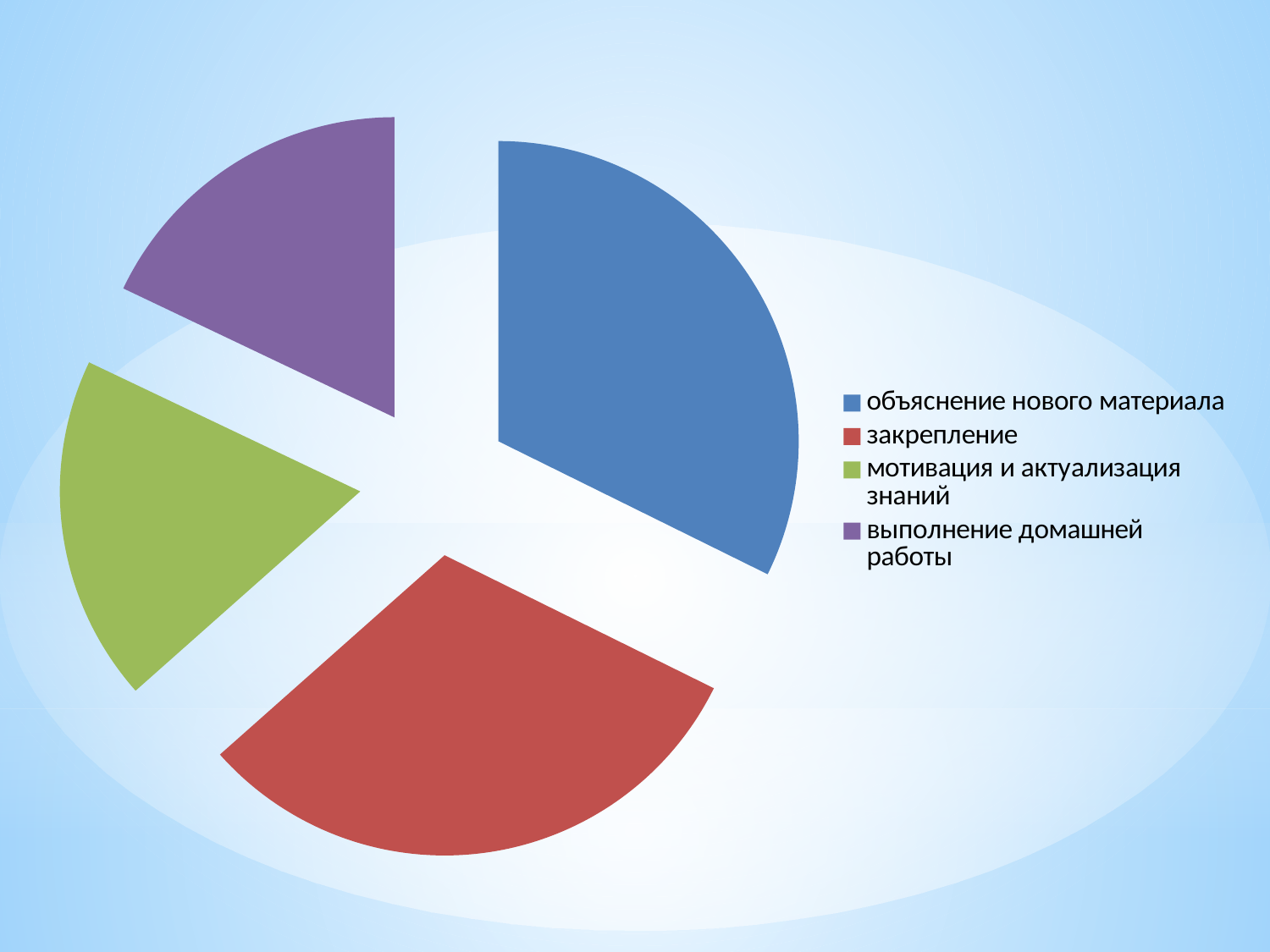
Which category is shown in purple in the pie chart? выполнение домашней работы Which slice is larger: закрепление or выполнение домашней работы? закрепление How many entries does the legend of the pie chart list? 4 Which slice is larger: закрепление or мотивация и актуализация знаний? закрепление Which slice is larger: объяснение нового материала or выполнение домашней работы? объяснение нового материала How many slices does the pie chart have? 4 What colour is the slice for закрепление in the pie chart? red What kind of chart is shown on the slide? pie chart